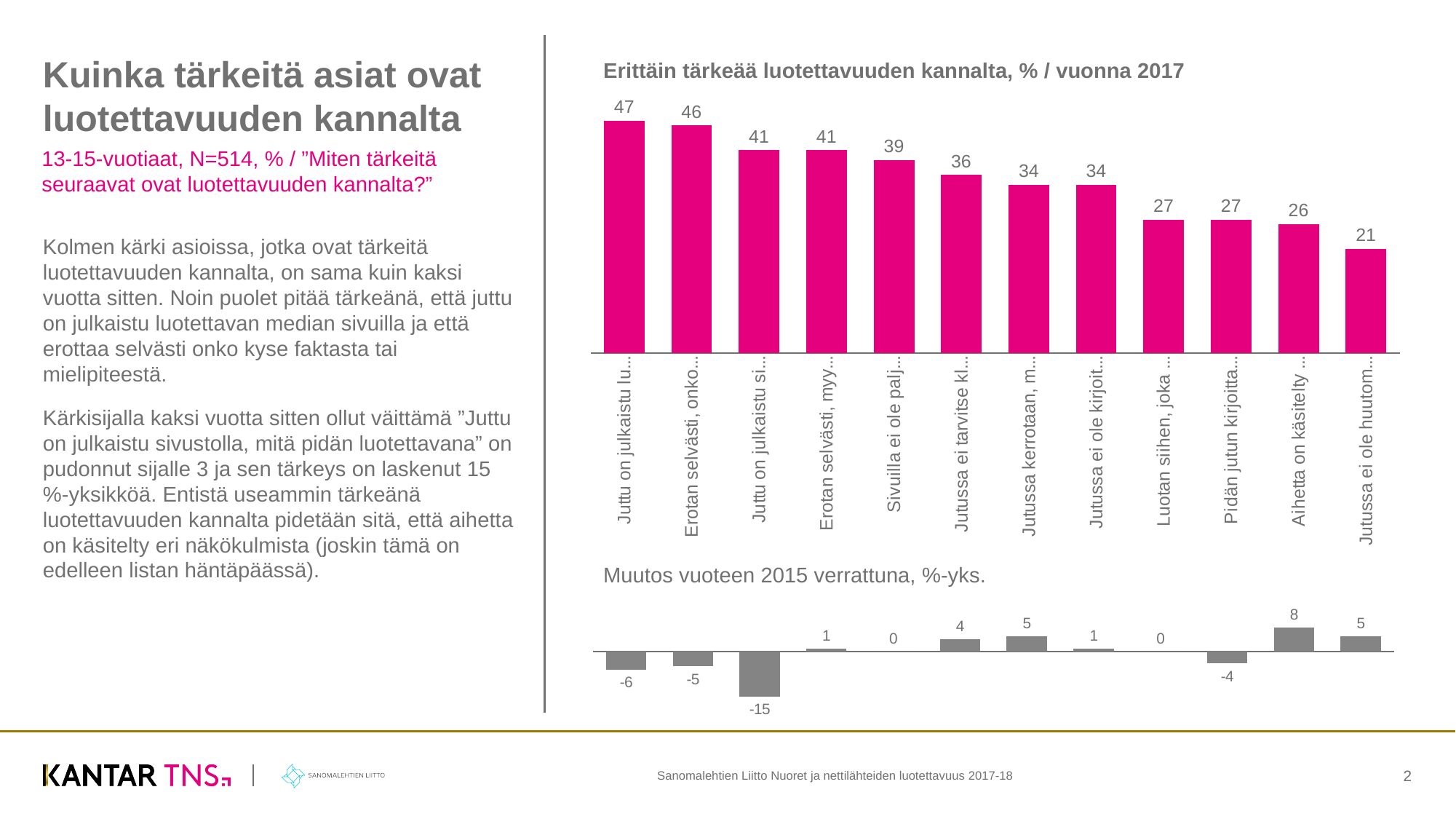
In the bottom chart 'Muutos vuoteen 2015 verrattuna, %-yks.', which category has the highest value? Aihetta on käsitelty ... How many bars are in the top chart 'Erittäin tärkeää luotettavuuden kannalta, % / vuonna 2017'? 12 In the top chart 'Erittäin tärkeää luotettavuuden kannalta, % / vuonna 2017', which category has the highest value? Juttu on julkaistu lu... In the top chart 'Erittäin tärkeää luotettavuuden kannalta, % / vuonna 2017', what is the value for 'Sivuilla ei ole palj...'? 39 In the top chart 'Erittäin tärkeää luotettavuuden kannalta, % / vuonna 2017', what is the difference between the highest value (47) and the lowest value (21)? 26 In the bottom chart 'Muutos vuoteen 2015 verrattuna, %-yks.', which is larger: the value for 'Jutussa kerrotaan, m...' or the value for 'Jutussa ei tarvitse kl...'? Jutussa kerrotaan, m... What kind of chart is the top chart 'Erittäin tärkeää luotettavuuden kannalta, % / vuonna 2017'? Bar chart In the top chart 'Erittäin tärkeää luotettavuuden kannalta, % / vuonna 2017', which category has the lowest value? Jutussa ei ole huutom... What is the title of the top chart on the slide? Erittäin tärkeää luotettavuuden kannalta, % / vuonna 2017 In the bottom chart 'Muutos vuoteen 2015 verrattuna, %-yks.', what is the lowest value shown? -15 In the bottom chart 'Muutos vuoteen 2015 verrattuna, %-yks.', what is the value of the first bar? -6 In the top chart 'Erittäin tärkeää luotettavuuden kannalta, % / vuonna 2017', what is the value for the first bar, 'Juttu on julkaistu lu...'? 47